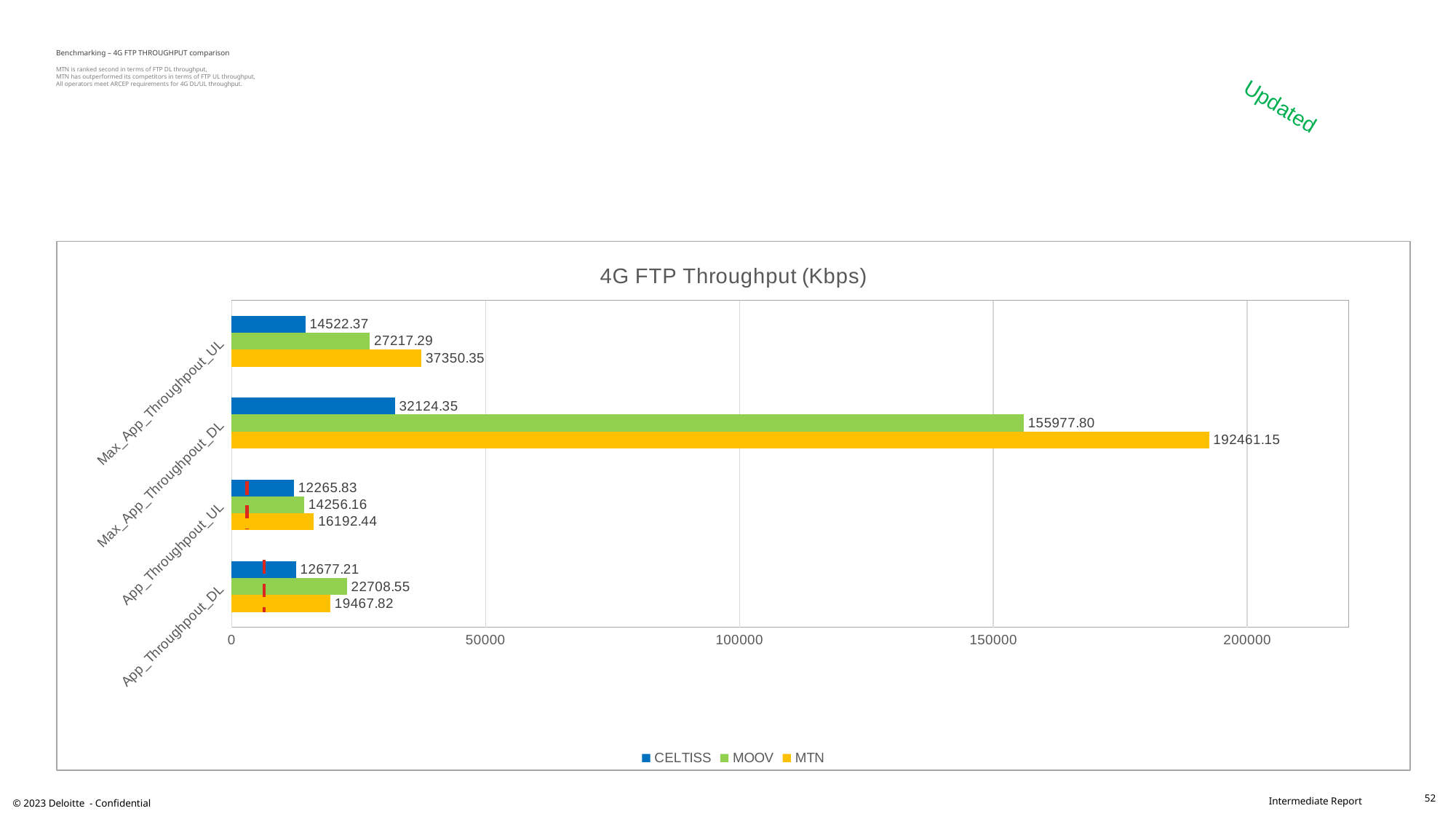
How many categories are shown on the vertical axis of the chart? 4 How many series does the legend list? 3 Is the MOOV value for Max_App_Throughpout_DL greater or less than 150000? greater What is the CELTISS value for App_Throughpout_UL? 12265.83 Which operator has the highest value for App_Throughpout_DL? MOOV Which operator has the lowest value for Max_App_Throughpout_DL? CELTISS What is the MTN value for Max_App_Throughpout_DL? 192461.15 What is the title of the chart? 4G FTP Throughput (Kbps) For App_Throughpout_UL, which is larger: the MOOV value or the MTN value? MTN What is the MOOV value for Max_App_Throughpout_UL? 27217.29 What is the difference between the MTN and MOOV values for Max_App_Throughpout_DL? 36483.35 What type of chart is shown on the slide? Bar chart